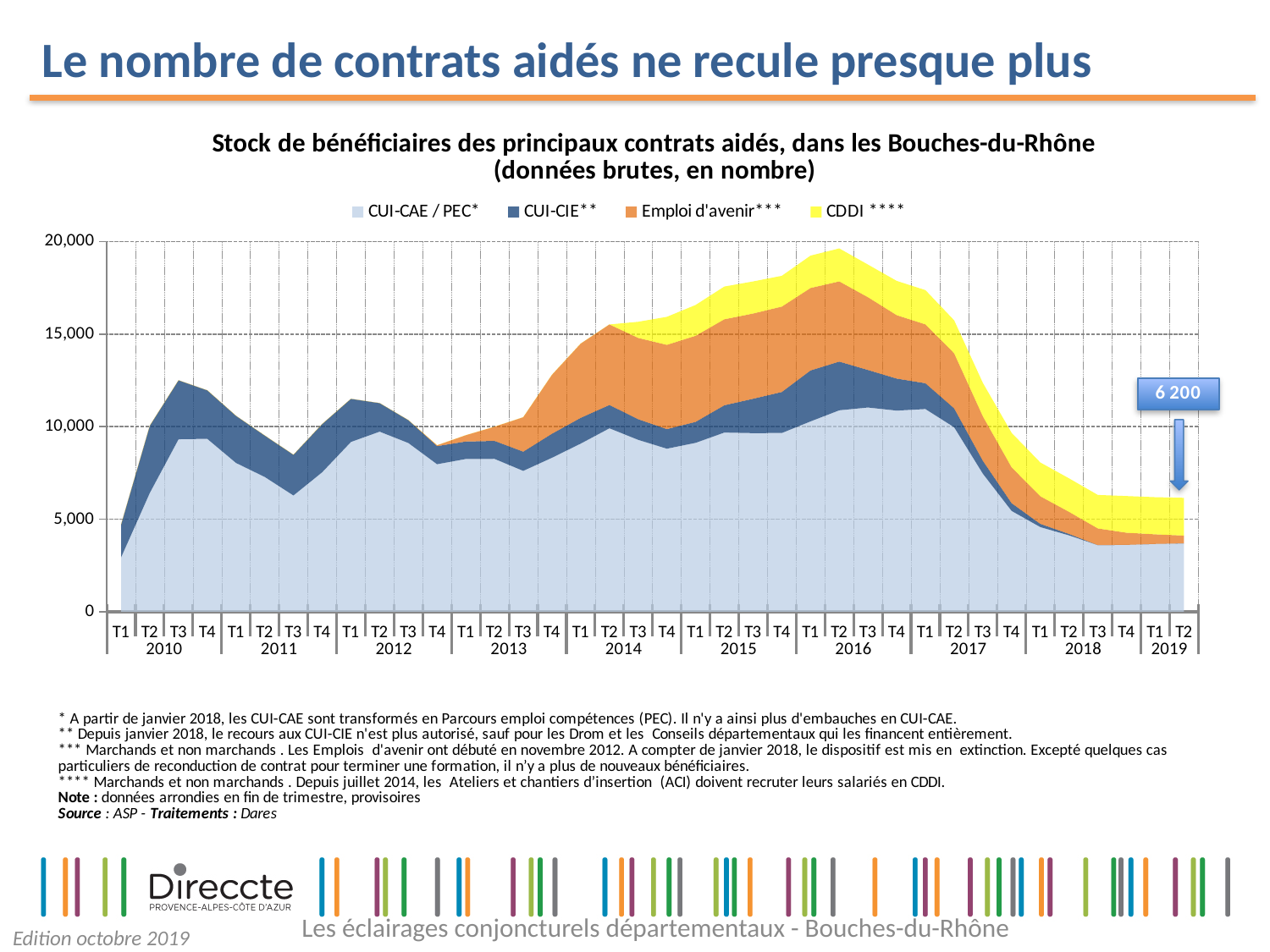
What is the title of the chart? Stock de bénéficiaires des principaux contrats aidés, dans les Bouches-du-Rhône (données brutes, en nombre) Is the total stacked value at T2 2016 greater or less than 15,000? greater Which series forms the bottom layer of the stacked area? CUI-CAE / PEC* In which quarter does the total stacked value reach its highest point? T2 2016 Is the total stacked value at T3 2010 greater or less than 10,000? greater How many years are shown on the x axis? 10 What total value is labelled for T2 2019? 6 200 What kind of chart is shown on the slide? area chart How many series does the legend list? 4 Which is larger, the total at T2 2016 or the total at T2 2019? T2 2016 Do the total values rise or fall from T2 2016 to T2 2019? fall Is the total stacked value at T4 2018 greater or less than 10,000? less